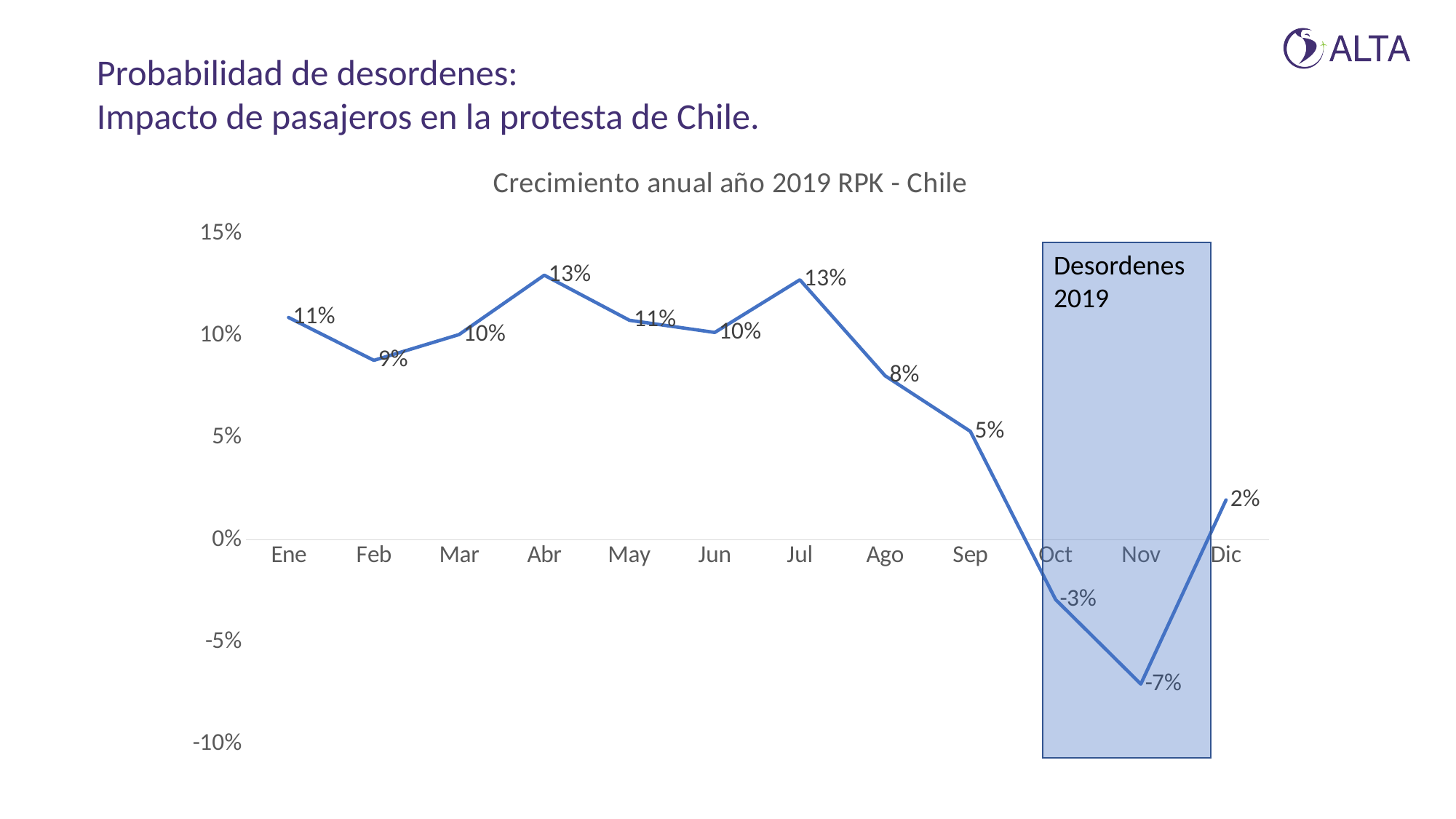
Which month has the lowest value? Nov Which is larger, the value for Feb or the value for Mar? Mar What is the value for Nov? -7% What is the title of the chart? Crecimiento anual año 2019 RPK - Chile What is the value for Sep? 5% What kind of chart is shown? line chart How many months are plotted on the chart? 12 What is the difference between the values for Oct and Nov? 4% Is the value for Ago greater or less than 10%? less What is the value for Oct? -3% What is the difference between the values for Sep and Ago? 3% What is the value for Dic? 2%